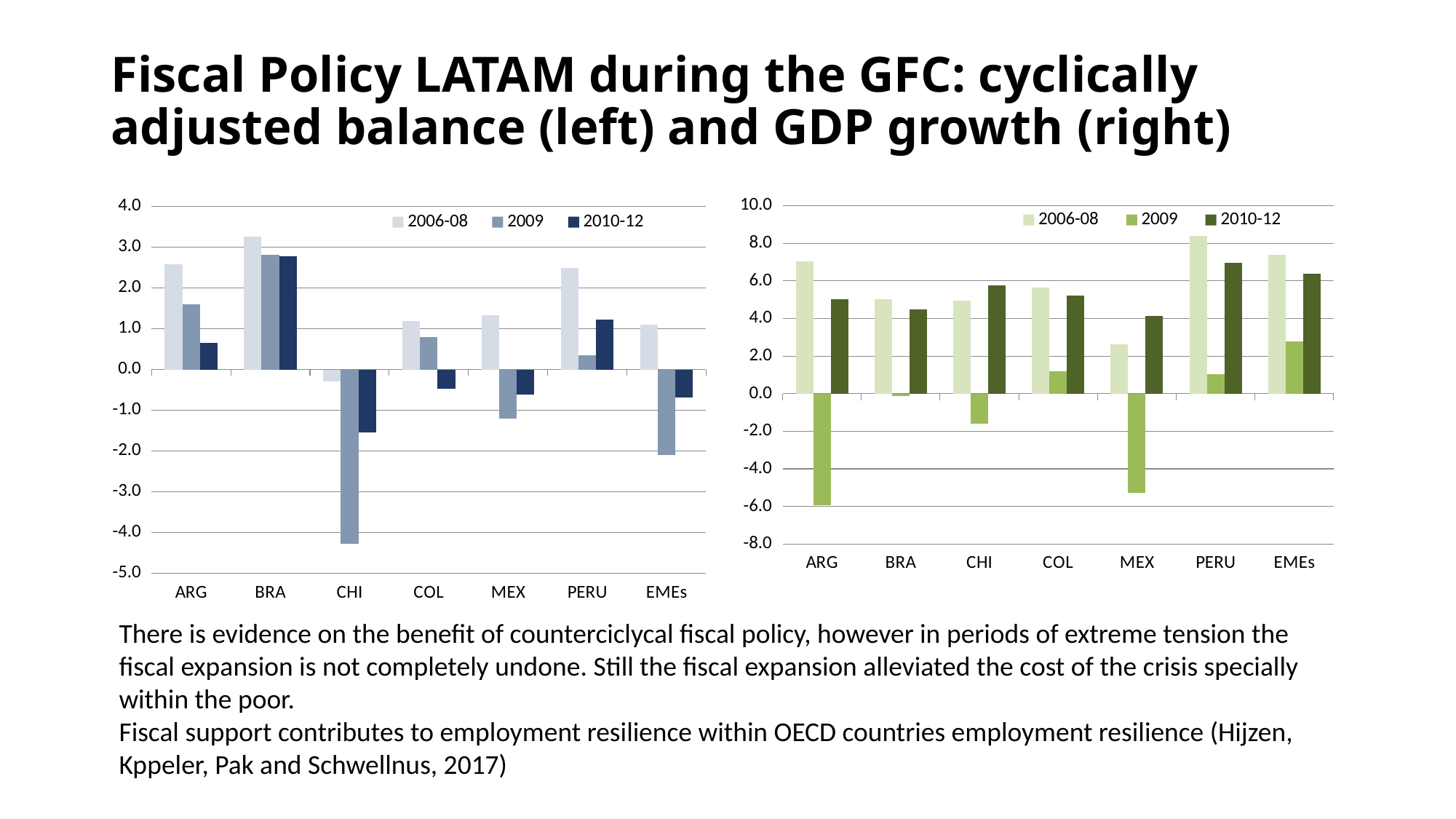
What kind of chart is the left chart (cyclically adjusted balance)? bar chart In the right chart (GDP growth), which category has the highest value for 2006-08? PERU In the right chart (GDP growth), which is larger for 2006-08: ARG or MEX? ARG In the left chart (cyclically adjusted balance), is the 2009 value for CHI greater or less than -4.0? less What are the legend entries of the right chart (GDP growth)? 2006-08, 2009, 2010-12 In the left chart (cyclically adjusted balance), is the 2006-08 value for BRA greater or less than 3.0? greater In the left chart (cyclically adjusted balance), which category has the highest value for 2006-08? BRA How many series does the legend of the left chart (cyclically adjusted balance) list? 3 In the right chart (GDP growth), is the 2006-08 value for PERU greater or less than 8.0? greater How many categories are shown on the x axis of the left chart (cyclically adjusted balance)? 7 In the left chart (cyclically adjusted balance), which category has the lowest value for 2009? CHI